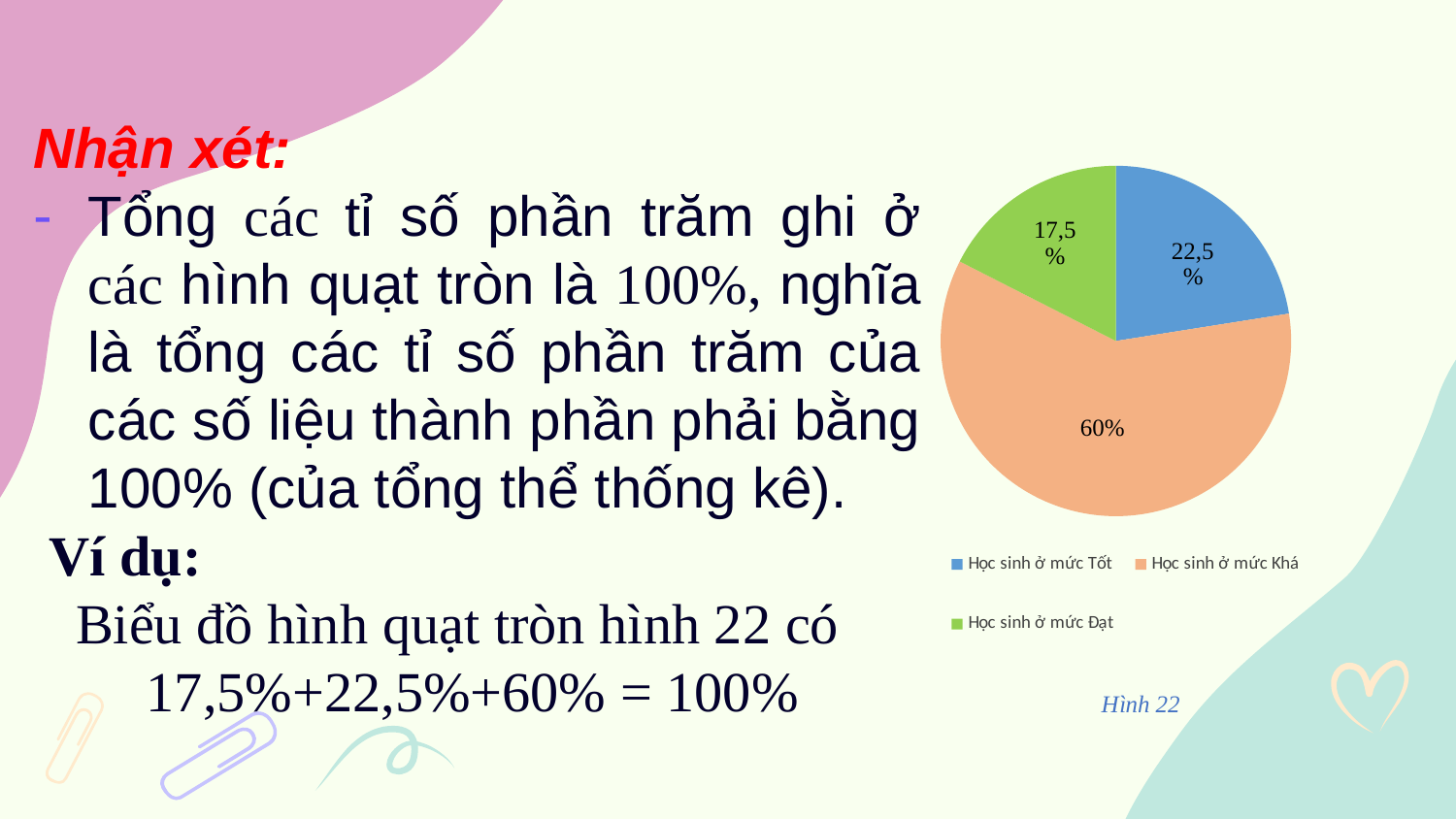
What percentage is shown for "Học sinh ở mức Đạt" in the pie chart? 17,5% What percentage is shown for "Học sinh ở mức Tốt" in the pie chart? 22,5% Which category has the largest slice in the pie chart? Học sinh ở mức Khá Which category has the smallest slice in the pie chart? Học sinh ở mức Đạt What percentage is shown for "Học sinh ở mức Khá" in the pie chart? 60% What kind of chart is shown on the slide? pie chart How many slices does the pie chart have? 3 What figure label is written below the pie chart? Hình 22 Which is larger in the pie chart: "Học sinh ở mức Tốt" or "Học sinh ở mức Đạt"? Học sinh ở mức Tốt How many entries does the legend of the pie chart list? 3 What is the difference in percentage points between "Học sinh ở mức Khá" and "Học sinh ở mức Tốt" in the pie chart? 37,5 What colour is the slice for "Học sinh ở mức Khá" in the pie chart? orange